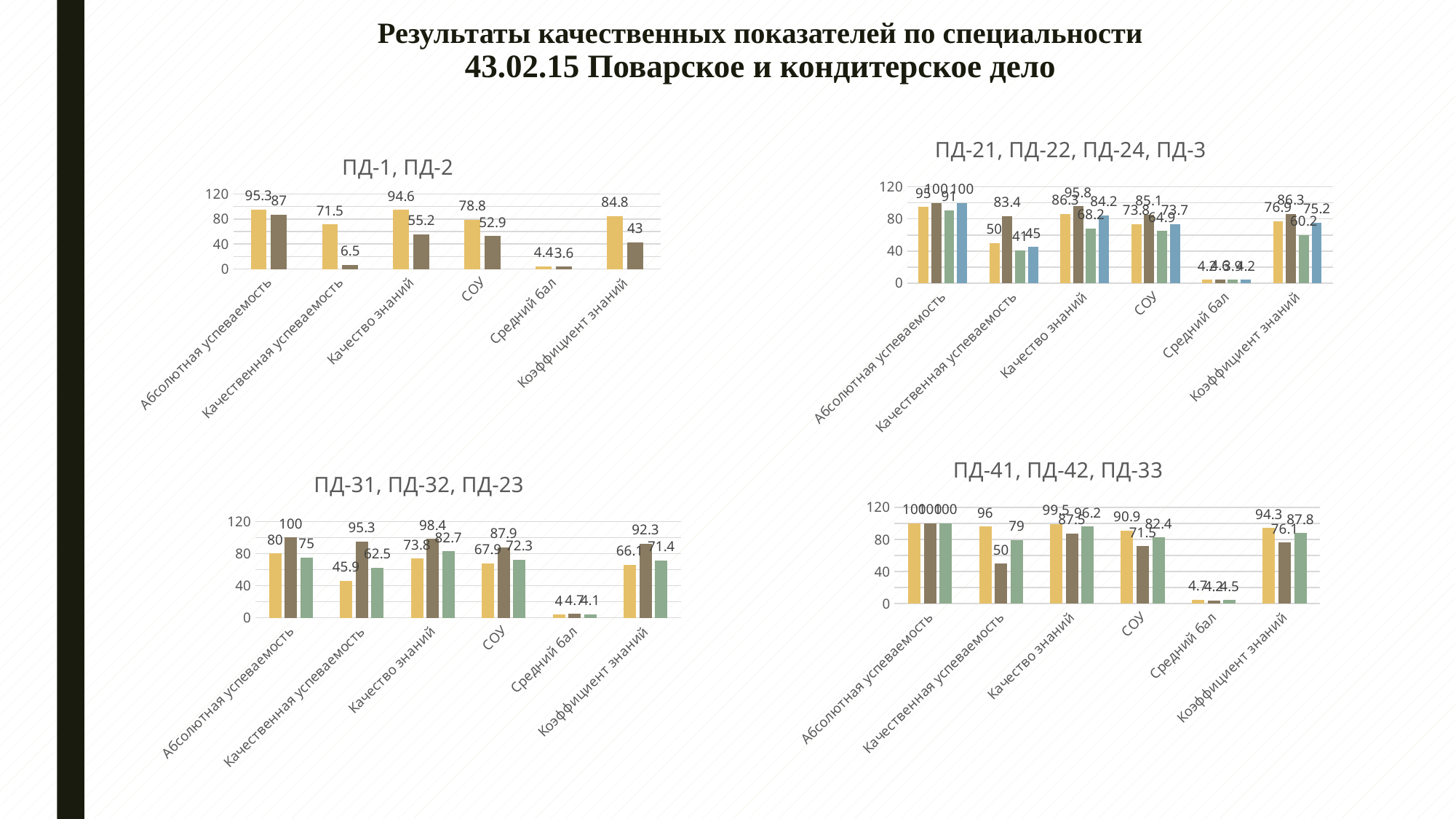
In the chart titled "ПД-41, ПД-42, ПД-33", what is the value of the second (brown) bar for Качественная успеваемость? 50 In the chart titled "ПД-21, ПД-22, ПД-24, ПД-3", how many bars are shown for each category? 4 What type of chart is used for "ПД-31, ПД-32, ПД-23"? bar chart In the chart titled "ПД-1, ПД-2", what is the difference between the two bars for Качество знаний? 39.4 In the chart titled "ПД-31, ПД-32, ПД-23", which of the three bars for СОУ is the highest? the second (brown) bar, 87.9 How many categories are shown on the x axis of the chart titled "ПД-1, ПД-2"? 6 In the chart titled "ПД-41, ПД-42, ПД-33", which is larger for Коэффициент знаний: the first (yellow) bar or the third (green) bar? the first (yellow) bar, 94.3 In the chart titled "ПД-1, ПД-2", what is the value of the first (yellow) bar for Качественная успеваемость? 71.5 In the chart titled "ПД-21, ПД-22, ПД-24, ПД-3", what is the value of the second (brown) bar for Качественная успеваемость? 83.4 In the chart titled "ПД-31, ПД-32, ПД-23", what is the value of the second (brown) bar for Качественная успеваемость? 95.3 In the chart titled "ПД-41, ПД-42, ПД-33", what value do all three bars for Абсолютная успеваемость show? 100 In the chart titled "ПД-1, ПД-2", what is the value of the second (brown) bar for Коэффициент знаний? 43